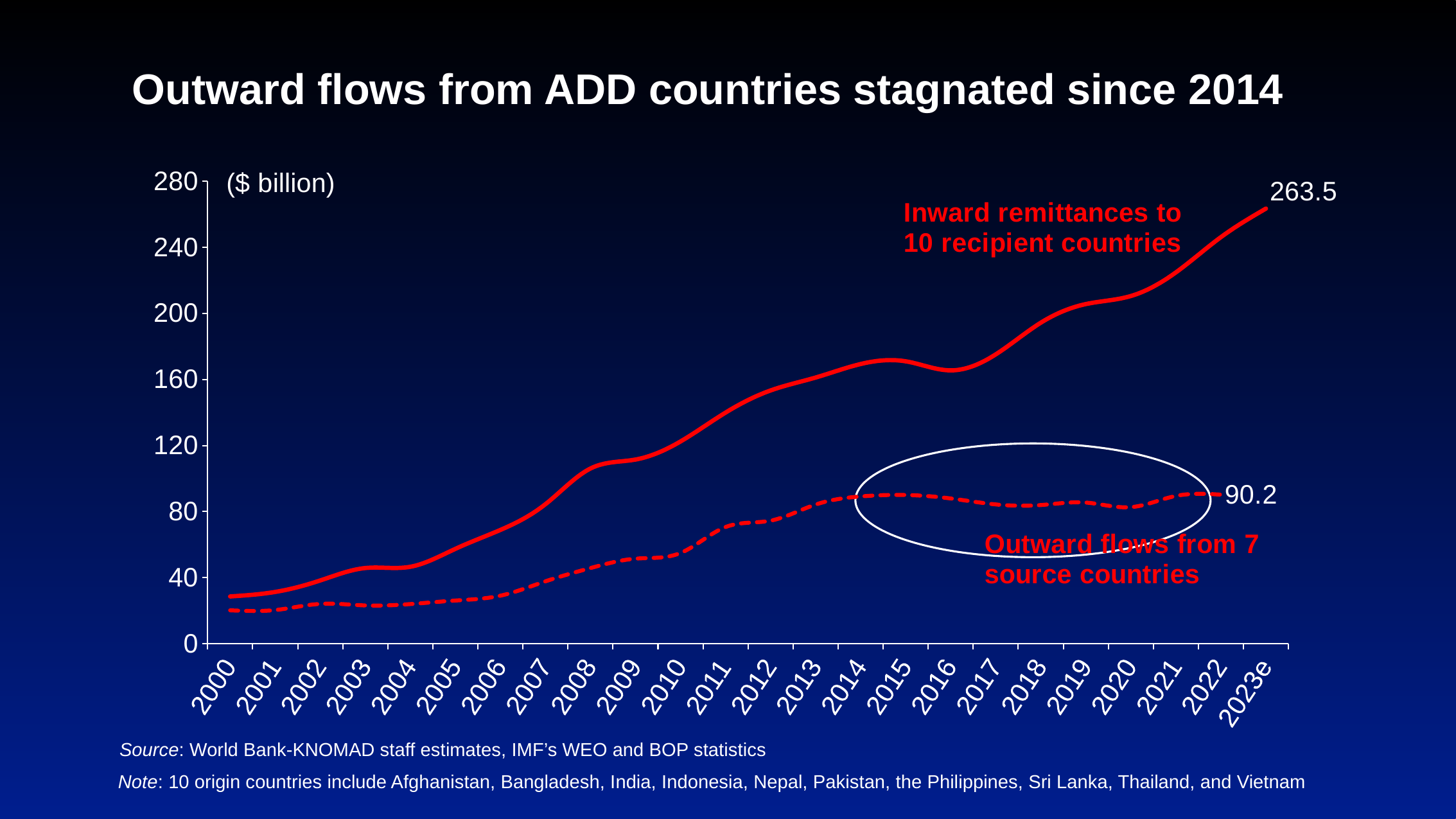
Is the value of outward flows in 2010 greater or less than 40? greater What is the value of inward remittances to 10 recipient countries in 2023e? 263.5 Is the value of inward remittances in 2008 greater or less than 80? greater How many lines are plotted on the chart? 2 What type of chart is shown on the slide? Line chart How many years are shown on the x axis? 24 Which series has the larger value in 2023e, inward remittances or outward flows? Inward remittances to 10 recipient countries Is the value of inward remittances in 2000 greater or less than 40? less What unit is shown for the y axis? $ billion Do inward remittances to 10 recipient countries generally rise or fall from 2000 to 2023e? Rise